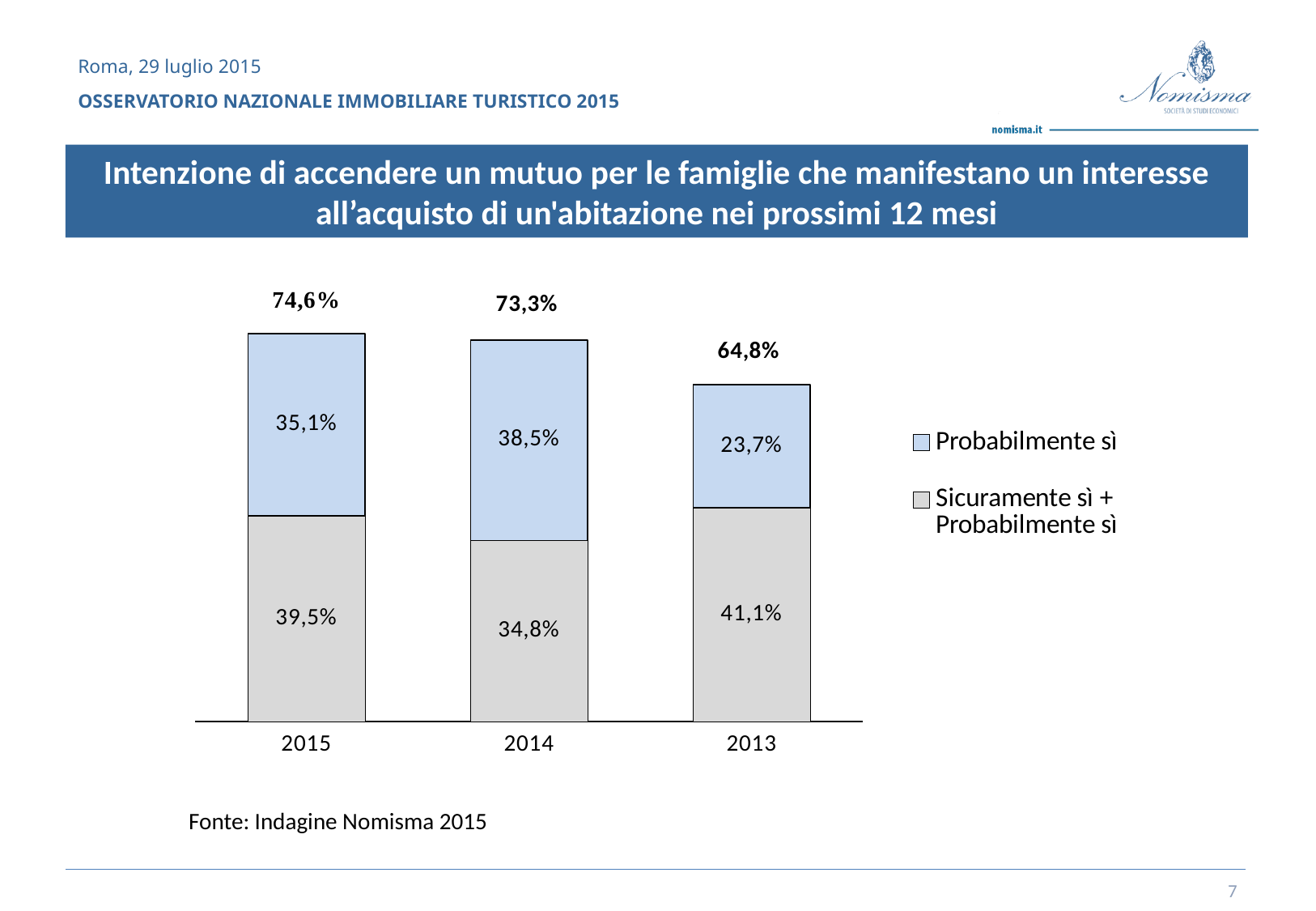
What is the value of the 'Sicuramente sì + Probabilmente sì' segment for 2013? 41,1% What is the value of the 'Probabilmente sì' segment for 2014? 38,5% What kind of chart is shown on the slide? Stacked bar chart What is the value of the 'Probabilmente sì' segment for 2015? 35,1% What is the total shown above the bar for 2013? 64,8% Which year has the lowest 'Probabilmente sì' value? 2013 Which is larger: the 'Sicuramente sì + Probabilmente sì' value for 2015 or for 2014? 2015 Which colour represents the 'Probabilmente sì' series? Light blue How many series does the legend list? 2 What is the difference between the total for 2015 and the total for 2013? 9,8% How many categories (years) are shown on the x axis? 3 Which year has the highest total value? 2015